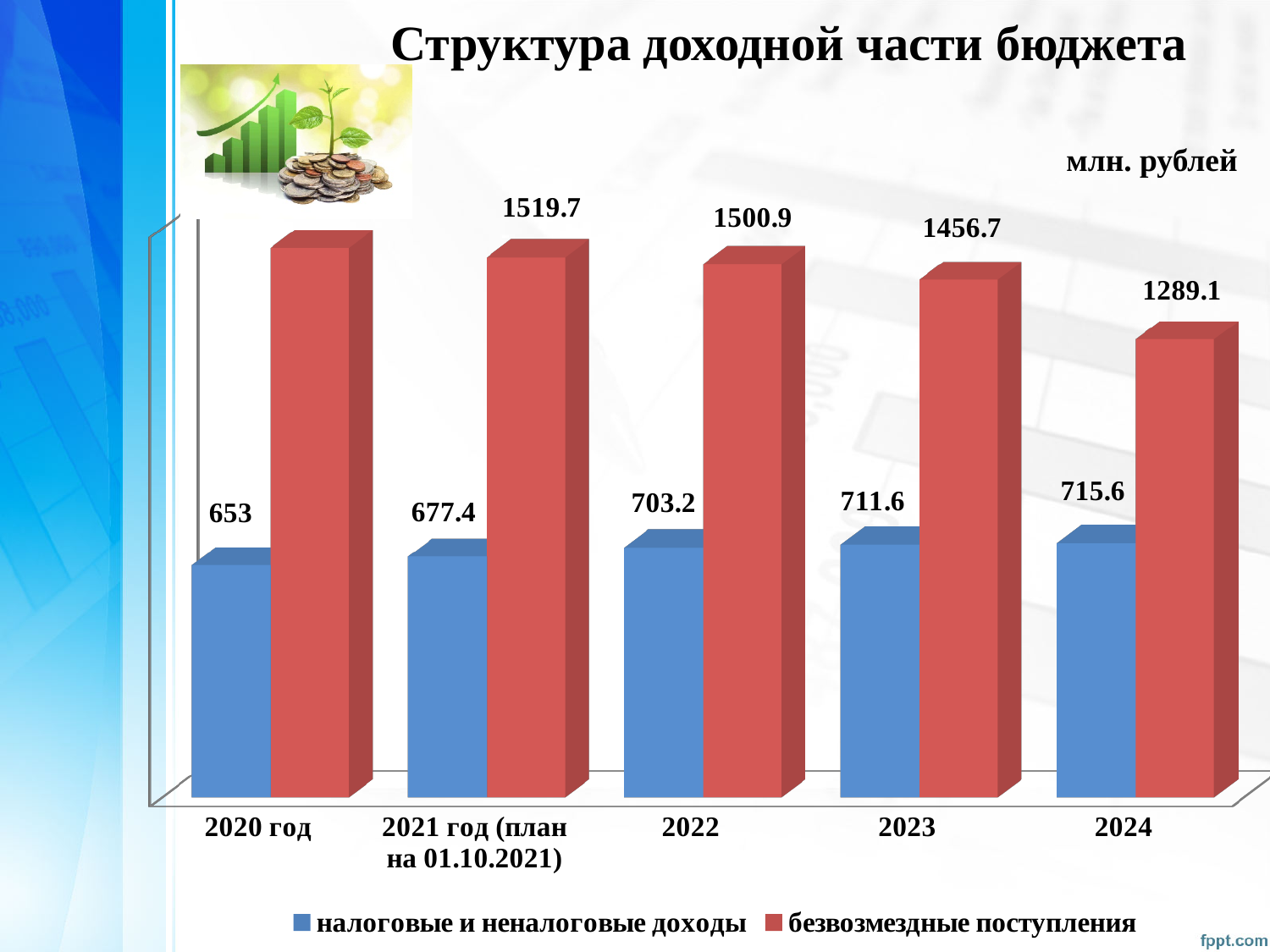
How many categories are shown on the x axis? 5 Do the values for налоговые и неналоговые доходы rise or fall from 2020 год to 2024? rise Which category has the highest value for налоговые и неналоговые доходы? 2024 What is the value of налоговые и неналоговые доходы for 2020 год? 653 What unit is stated for the values on the chart? млн. рублей Which category has the lowest value for налоговые и неналоговые доходы? 2020 год What is the value of безвозмездные поступления for 2024? 1289.1 What type of chart is shown on the slide? bar chart What is the value of налоговые и неналоговые доходы for 2023? 711.6 What is the value of безвозмездные поступления for 2022? 1500.9 How many series does the legend list? 2 What is the difference between безвозмездные поступления in 2021 год (план на 01.10.2021) and in 2024? 230.6